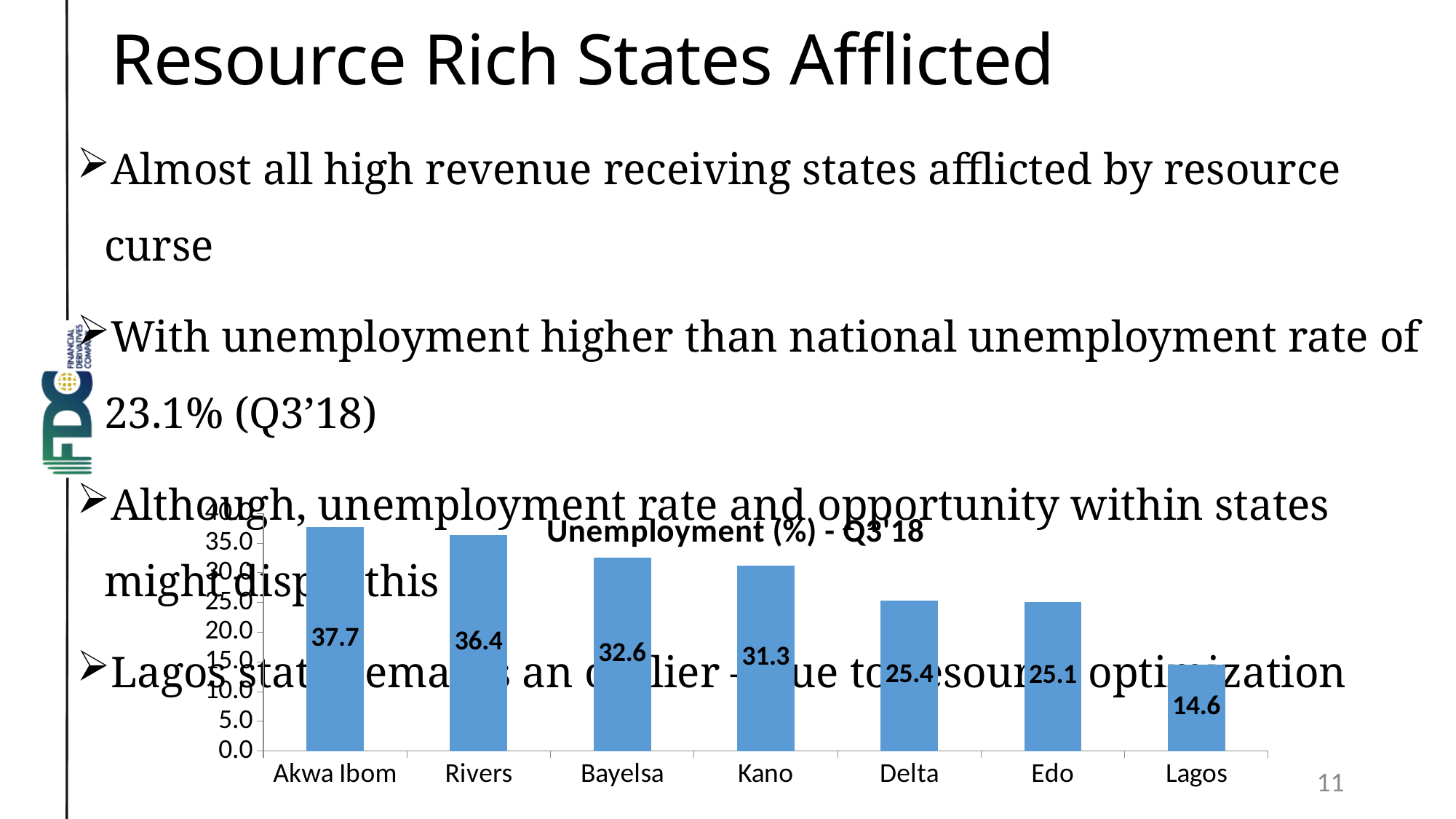
What is the unemployment rate shown for Bayelsa? 32.6 Which state has the highest unemployment rate in the chart? Akwa Ibom Is the value for Kano greater or less than 30.0? greater How many states are shown in the chart? 7 Which has a higher unemployment rate, Bayelsa or Edo? Bayelsa What is the unemployment rate shown for Akwa Ibom? 37.7 What is the difference between the unemployment rates of Rivers and Kano? 5.1 Do the values rise or fall from left to right across the states? Fall What is the difference between the unemployment rates of Akwa Ibom and Lagos? 23.1 What kind of chart is used to show the unemployment rates? Bar chart What is the unemployment rate shown for Lagos? 14.6 Which state has the lowest unemployment rate in the chart? Lagos